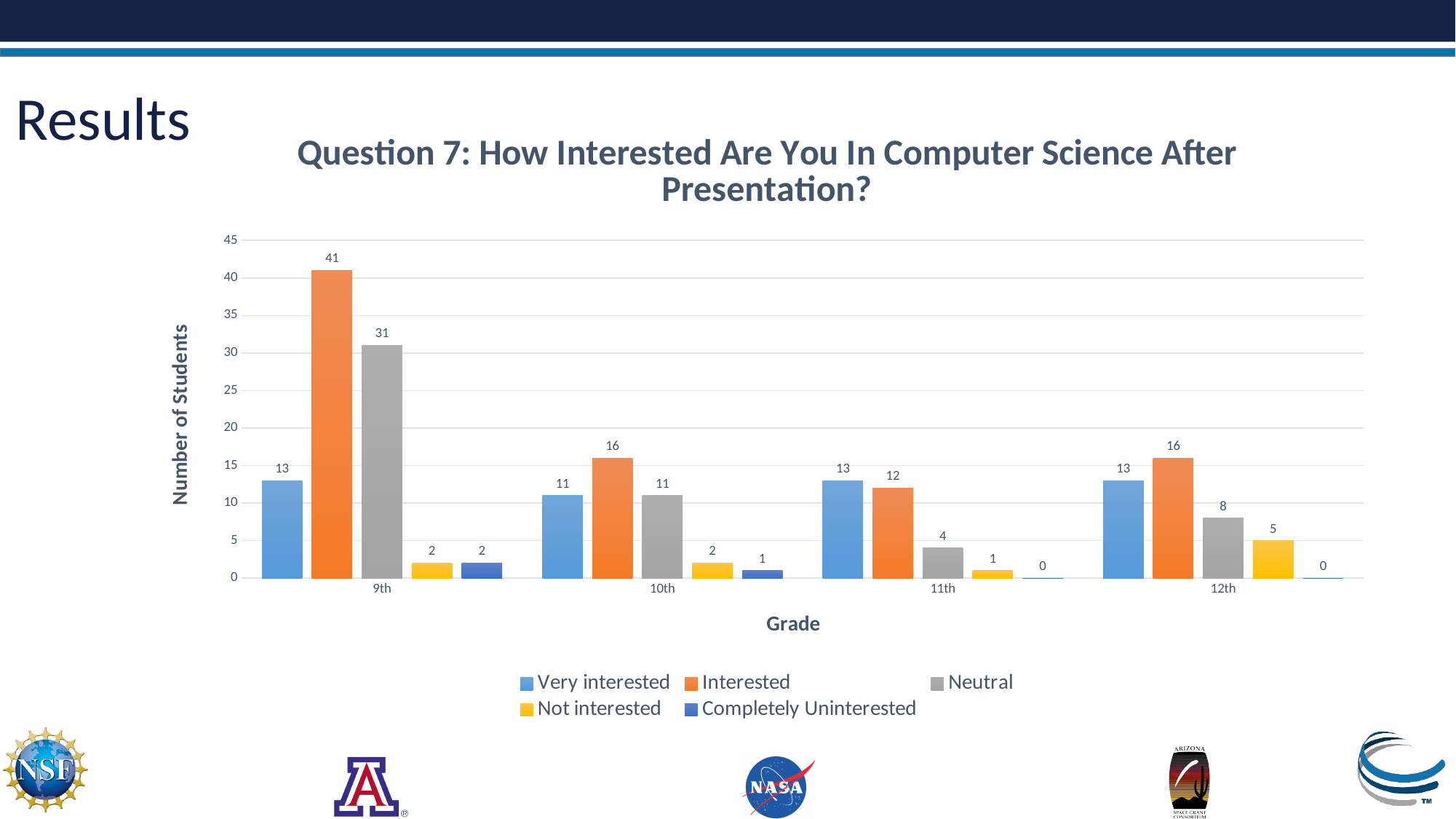
Which grade has the lowest number of "Neutral" students? 11th What kind of chart is shown on the slide? Bar chart How many series does the legend list? 5 How many 11th grade students answered "Completely Uninterested"? 0 What is the difference between the "Interested" and "Neutral" values for 9th grade? 10 Which is larger for 12th grade: "Very interested" or "Not interested"? Very interested Which grade has the highest number of "Interested" students? 9th How many 9th grade students answered "Interested"? 41 What is the value for "Neutral" in 12th grade? 8 What is the label of the y axis? Number of Students Is the value for "Interested" in 9th grade greater or less than 40? greater How many grade categories are shown on the x axis? 4